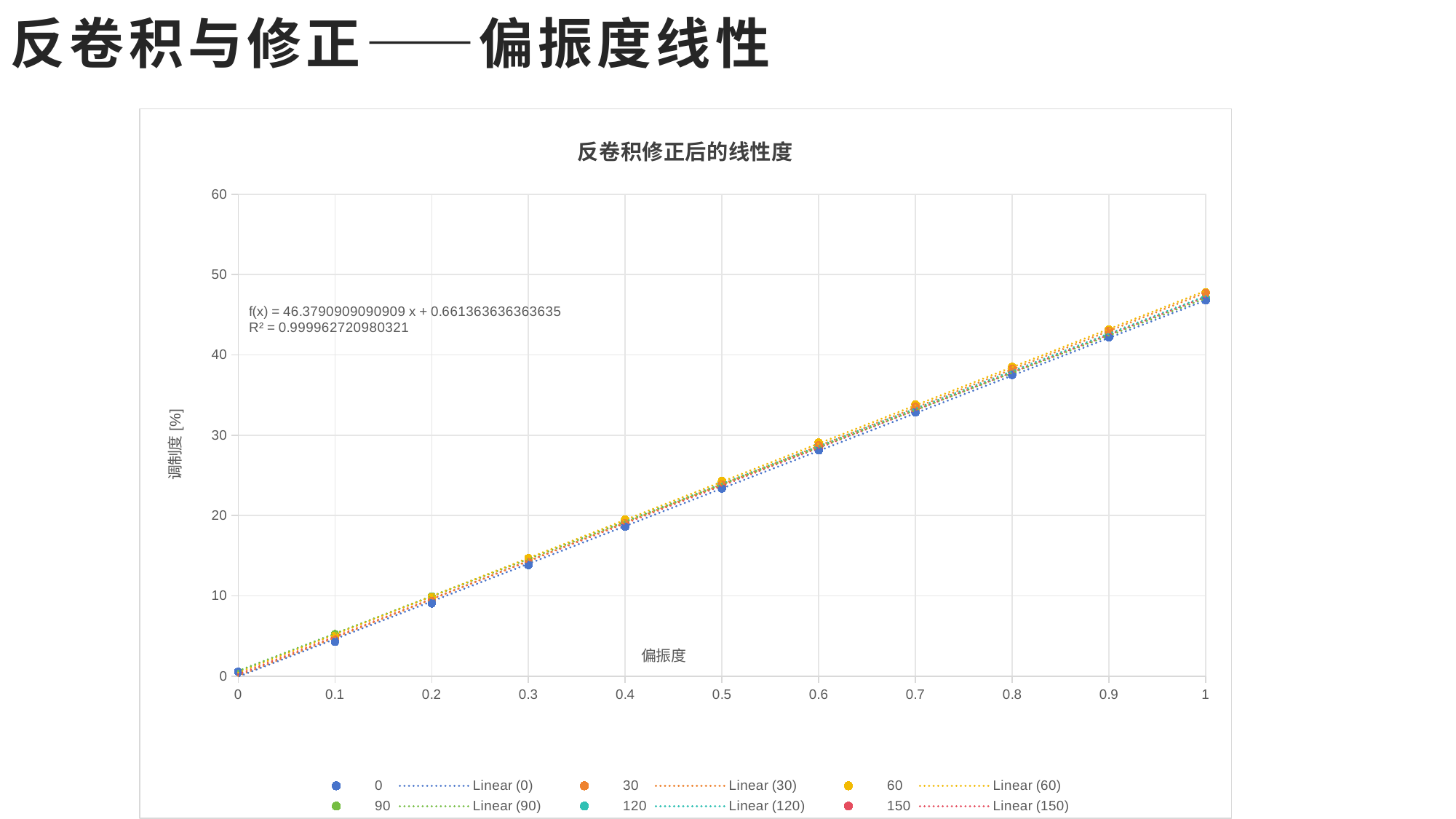
What R² value is printed on the chart? 0.999962720980321 Is the value for series 0 at 偏振度 = 1 greater or less than 40? greater Is the value for series 0 at 偏振度 = 0.3 greater or less than 20? less Is the value for series 30 at 偏振度 = 0.5 greater or less than 20? greater Do the plotted values rise or fall as 偏振度 increases from 0 to 1? rise What type of chart is shown on the slide? scatter chart What is the title of the chart? 反卷积修正后的线性度 How many data series (excluding the Linear trendlines) does the legend list? 6 How many x-axis positions (偏振度 values) have plotted points? 11 What is the label of the y axis? 调制度 [%]